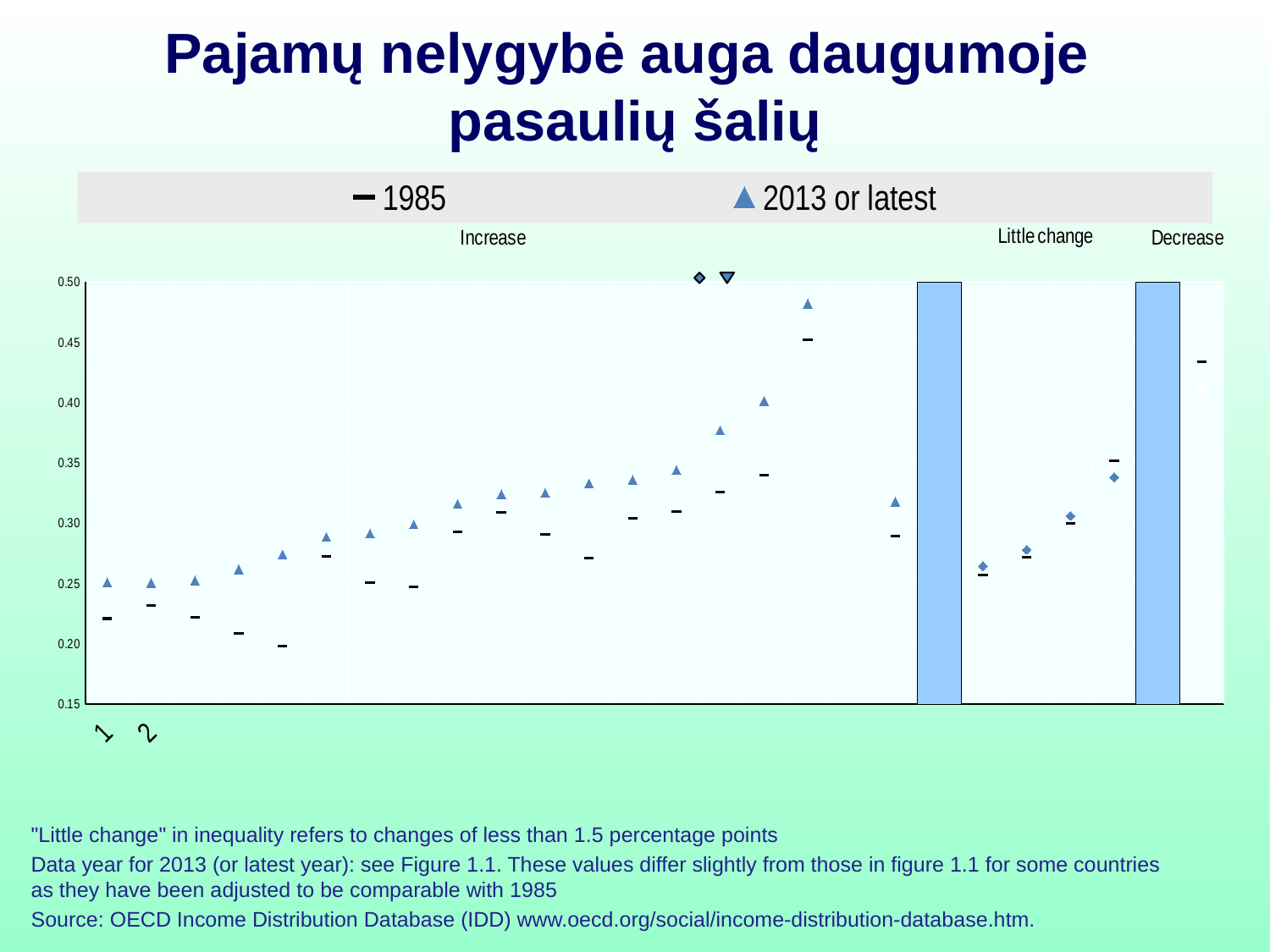
How many series does the legend list? 2 Is the 2013 or latest value for category 1 greater or less than 0.20? greater Within the Increase section, do the 2013 or latest values generally rise or fall from left to right? rise What are the two series named in the legend? 1985 and 2013 or latest Is the 1985 value for category 1 greater or less than 0.25? less What are the three section labels shown above the chart area? Increase, Little change, Decrease What is the lowest value shown on the vertical axis? 0.15 Is the 1985 value for category 2 greater or less than 0.25? less In which section of the chart does the highest 2013 or latest value appear? Increase For category 1, which series has the larger value, 1985 or 2013 or latest? 2013 or latest